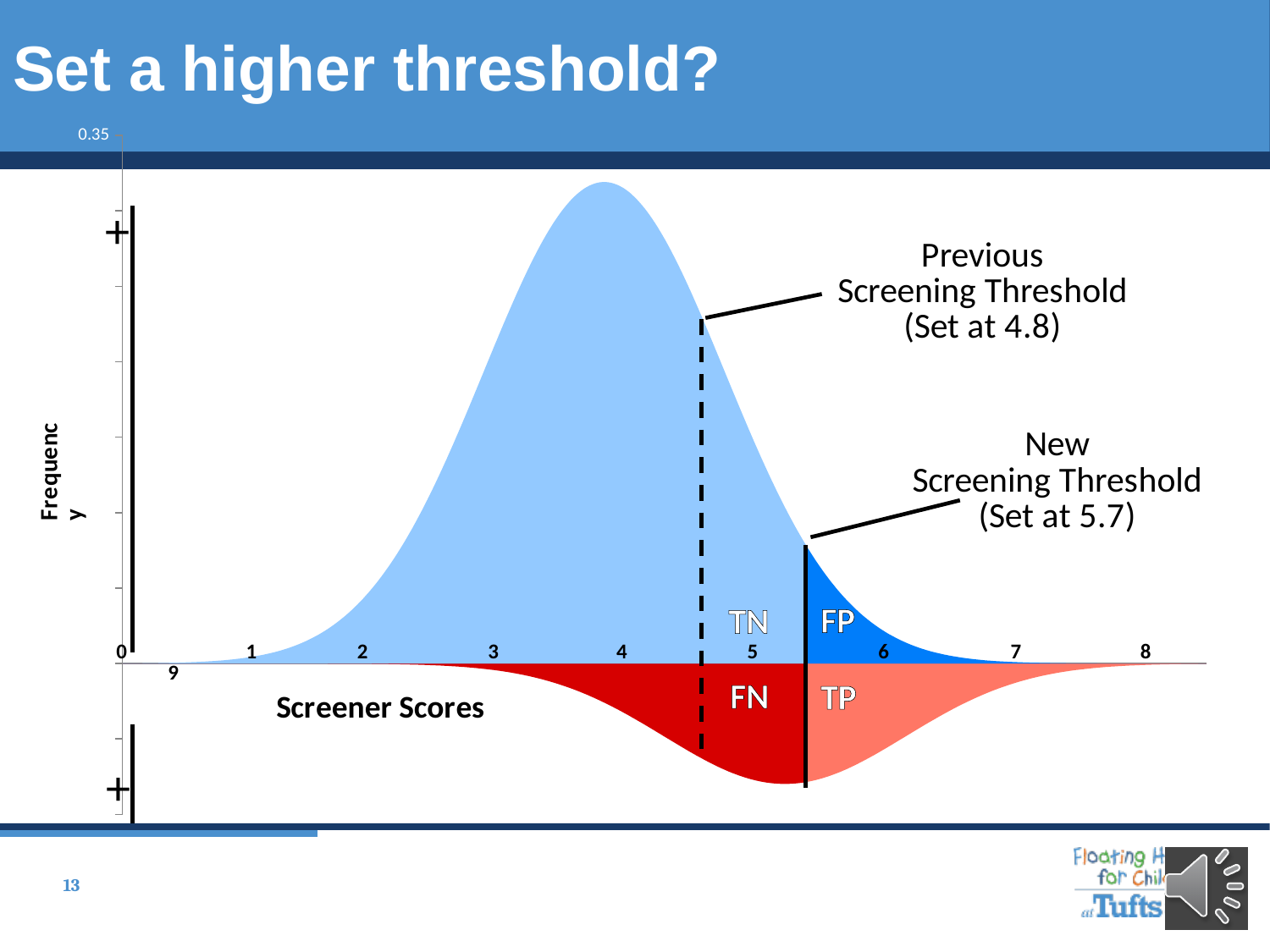
Between screener scores 4 and 7, does the upper (light blue) curve rise or fall? fall How many numbered tick labels (0 through 8) appear along the Screener Scores axis? 9 What kind of chart is shown on the slide? area chart Between screener scores 6 and 8, does the lower (red) curve move toward or away from the axis? toward Is the upper (light blue) curve higher at screener score 4 or at screener score 6? 4 Is the lower (red) curve further from the axis at screener score 5 or at screener score 2? 5 At what score is the previous screening threshold set, according to the annotation? 4.8 At what score is the new screening threshold set, according to the annotation? 5.7 Is the upper (light blue) curve higher at screener score 2 or at screener score 4? 4 Between screener scores 1 and 4, does the upper (light blue) curve rise or fall? rise